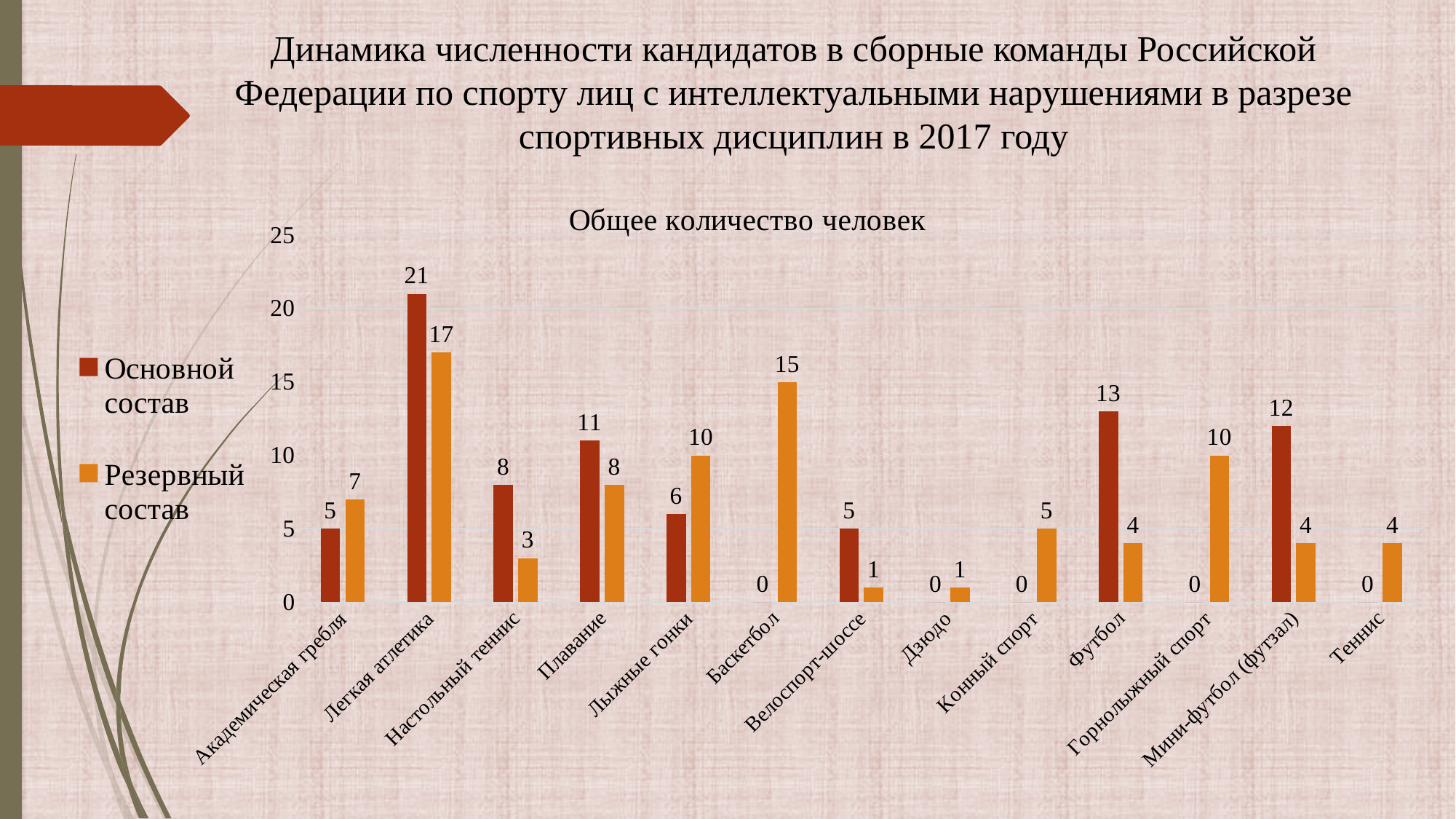
What is the value for Основной состав in Мини-футбол (футзал)? 12 What is the value for Резервный состав in Баскетбол? 15 Which category has the highest value for Основной состав? Легкая атлетика What is the difference between Основной состав and Резервный состав in Футбол? 9 Which is larger in Лыжные гонки: Основной состав or Резервный состав? Резервный состав How many sport disciplines are shown on the x axis? 13 What is the title of the chart? Общее количество человек Which category has the lowest value for Резервный состав? Велоспорт-шоссе and Дзюдо (both 1) What is the value for Основной состав in Легкая атлетика? 21 What is the total of Основной состав and Резервный состав for Плавание? 19 What kind of chart is shown on the slide? Bar chart How many series does the legend list? 2